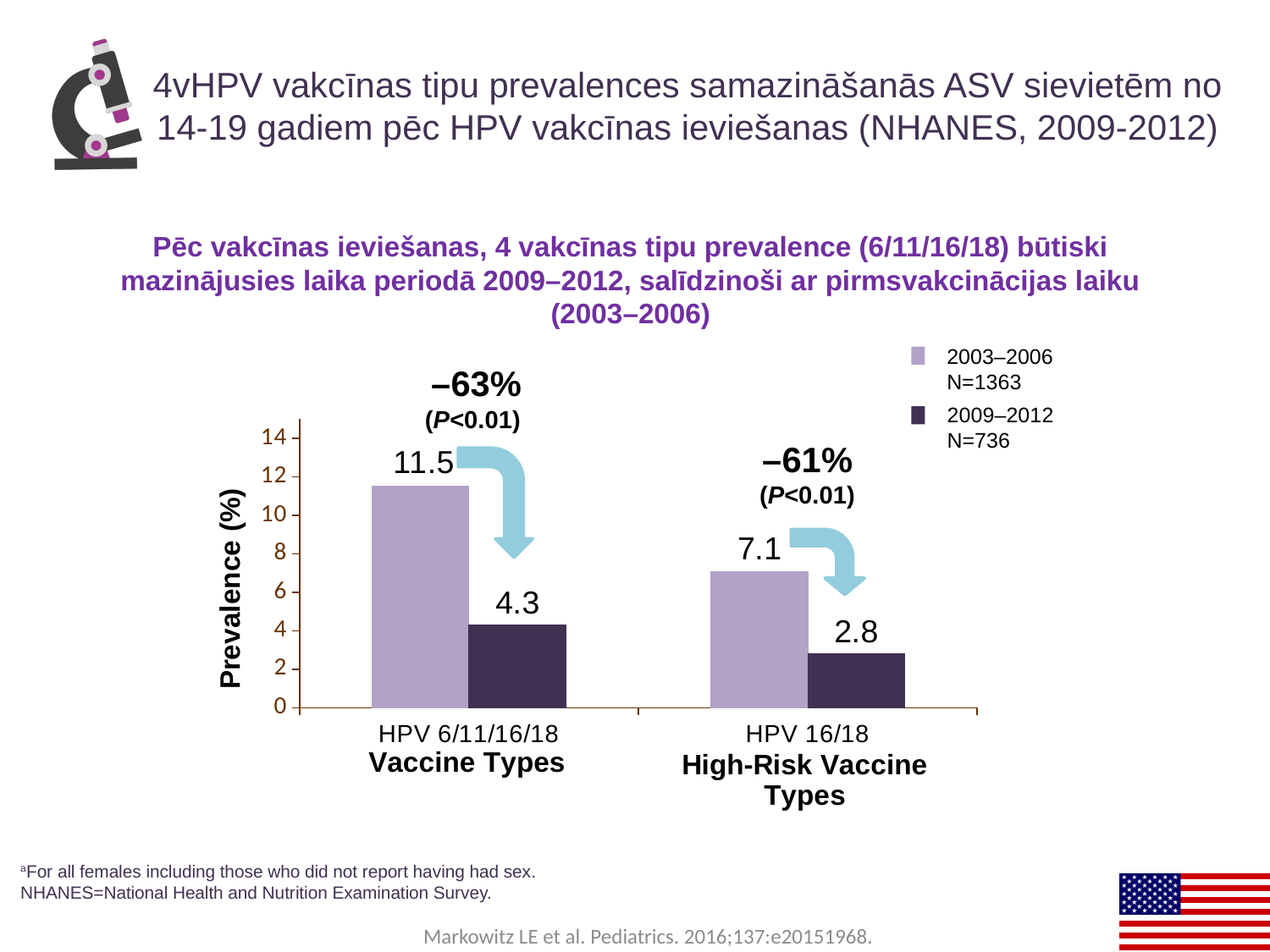
How many series does the legend list? 2 What kind of chart is shown on the slide? Bar chart What is the prevalence (%) for HPV 16/18 in 2003–2006? 7.1 Which is larger: the 2009–2012 prevalence for HPV 6/11/16/18 or the 2003–2006 prevalence for HPV 16/18? 2003–2006 prevalence for HPV 16/18 What is the sample size (N) for the 2009–2012 series shown in the legend? N=736 What is the difference in prevalence (%) for HPV 16/18 between 2003–2006 and 2009–2012? 4.3 What is the prevalence (%) for HPV 16/18 in 2009–2012? 2.8 Which bar has the lowest prevalence on the chart? HPV 16/18, 2009–2012 What is the prevalence (%) for HPV 6/11/16/18 in 2009–2012? 4.3 What is the prevalence (%) for HPV 6/11/16/18 in 2003–2006? 11.5 Which bar has the highest prevalence on the chart? HPV 6/11/16/18, 2003–2006 What is the difference in prevalence (%) for HPV 6/11/16/18 between 2003–2006 and 2009–2012? 7.2